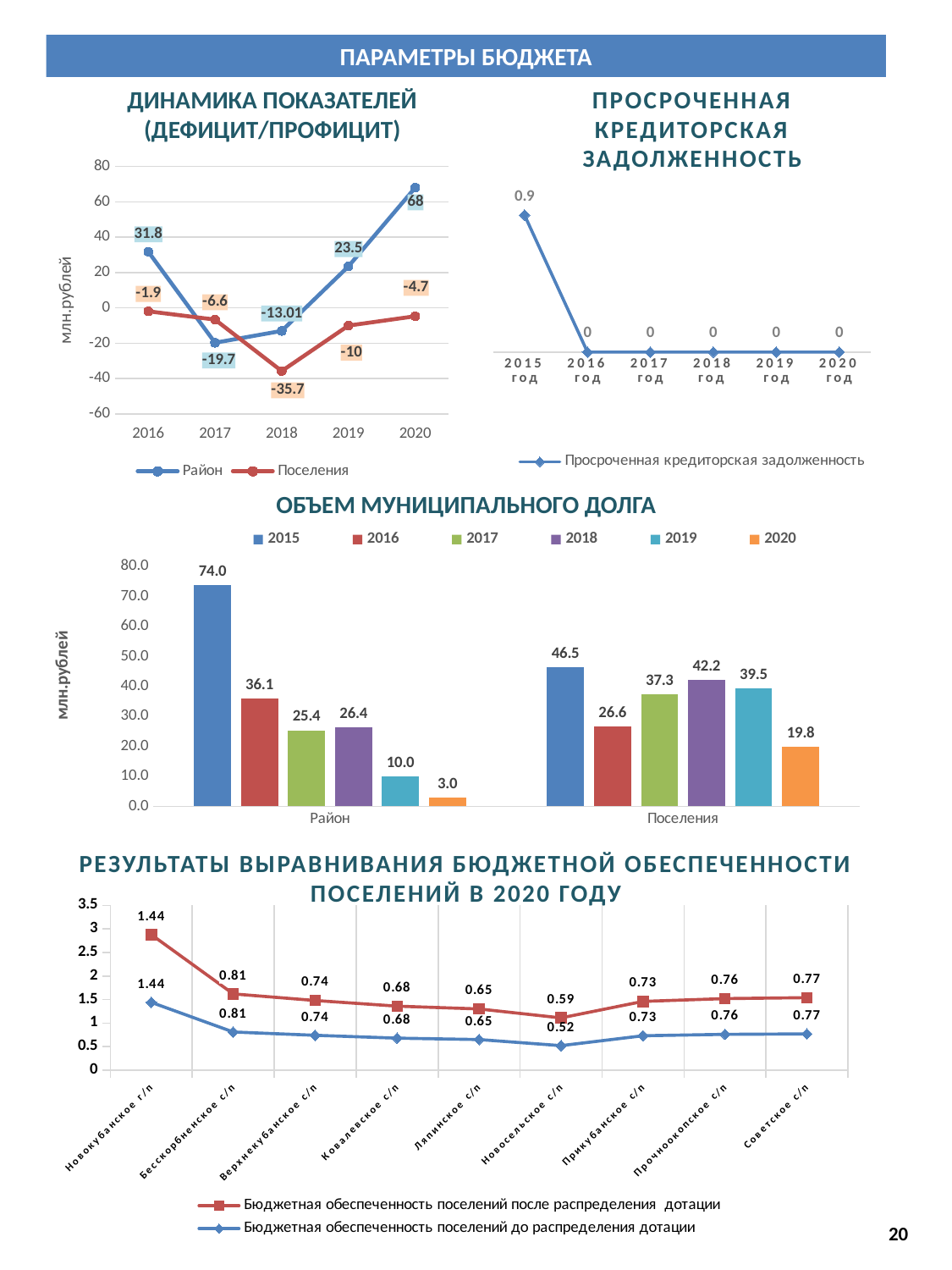
In the chart 'ПРОСРОЧЕННАЯ КРЕДИТОРСКАЯ ЗАДОЛЖЕННОСТЬ', how many years are shown on the x axis? 6 In the chart 'ОБЪЕМ МУНИЦИПАЛЬНОГО ДОЛГА', how many series does the legend list? 6 In the chart 'ДИНАМИКА ПОКАЗАТЕЛЕЙ (ДЕФИЦИТ/ПРОФИЦИТ)', what is the difference between the Район and Поселения values in 2019? 33.5 In the chart 'ДИНАМИКА ПОКАЗАТЕЛЕЙ (ДЕФИЦИТ/ПРОФИЦИТ)', in which year is the value for Поселения lowest? 2018 In the chart 'ОБЪЕМ МУНИЦИПАЛЬНОГО ДОЛГА', which year has the highest value for Район? 2015 In the chart 'ПРОСРОЧЕННАЯ КРЕДИТОРСКАЯ ЗАДОЛЖЕННОСТЬ', what is the value for 2015 год? 0.9 In the chart 'ОБЪЕМ МУНИЦИПАЛЬНОГО ДОЛГА', which is larger: the 2017 value for Район or the 2017 value for Поселения? Поселения In the chart 'ДИНАМИКА ПОКАЗАТЕЛЕЙ (ДЕФИЦИТ/ПРОФИЦИТ)', how many series does the legend list? 2 In the chart 'ДИНАМИКА ПОКАЗАТЕЛЕЙ (ДЕФИЦИТ/ПРОФИЦИТ)', what is the value for Район in 2020? 68 In the chart 'РЕЗУЛЬТАТЫ ВЫРАВНИВАНИЯ БЮДЖЕТНОЙ ОБЕСПЕЧЕННОСТИ ПОСЕЛЕНИЙ В 2020 ГОДУ', what is the value for Новосельское с/п after the distribution of subsidies (после распределения дотации)? 0.59 In the chart 'ОБЪЕМ МУНИЦИПАЛЬНОГО ДОЛГА', what is the value for Поселения in 2018? 42.2 What kind of chart is 'ОБЪЕМ МУНИЦИПАЛЬНОГО ДОЛГА'? bar chart